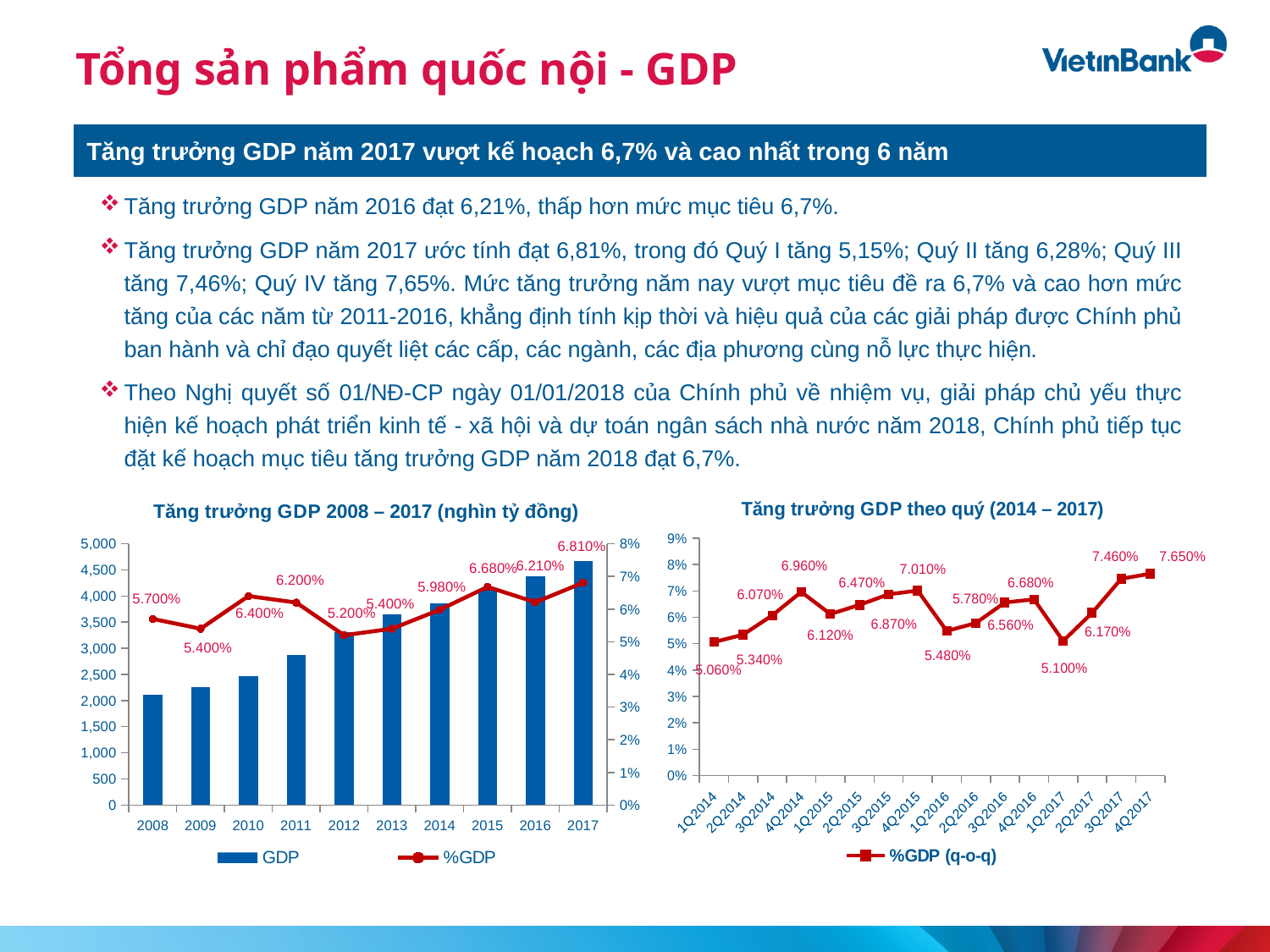
In the chart 'Tăng trưởng GDP theo quý (2014 – 2017)', what is the %GDP (q-o-q) value for 4Q2017? 7.650% In the chart 'Tăng trưởng GDP theo quý (2014 – 2017)', which quarter has the lowest %GDP (q-o-q) value? 1Q2014 In the chart 'Tăng trưởng GDP 2008 – 2017 (nghìn tỷ đồng)', do the GDP bars generally rise or fall from 2008 to 2017? rise In the chart 'Tăng trưởng GDP 2008 – 2017 (nghìn tỷ đồng)', is the GDP bar for 2008 greater or less than 2,500? less In the chart 'Tăng trưởng GDP 2008 – 2017 (nghìn tỷ đồng)', what is the difference between the %GDP values for 2017 and 2016? 0.600% In the chart 'Tăng trưởng GDP 2008 – 2017 (nghìn tỷ đồng)', how many series does the legend list? 2 What kind of chart is 'Tăng trưởng GDP theo quý (2014 – 2017)'? line chart In the chart 'Tăng trưởng GDP 2008 – 2017 (nghìn tỷ đồng)', what is the %GDP value for 2017? 6.810% In the chart 'Tăng trưởng GDP theo quý (2014 – 2017)', how many quarters are plotted? 16 In the chart 'Tăng trưởng GDP 2008 – 2017 (nghìn tỷ đồng)', which year has the lowest %GDP value? 2012 In the chart 'Tăng trưởng GDP 2008 – 2017 (nghìn tỷ đồng)', what is the %GDP value for 2012? 5.200% In the chart 'Tăng trưởng GDP 2008 – 2017 (nghìn tỷ đồng)', is the GDP bar for 2017 greater or less than 4,000? greater